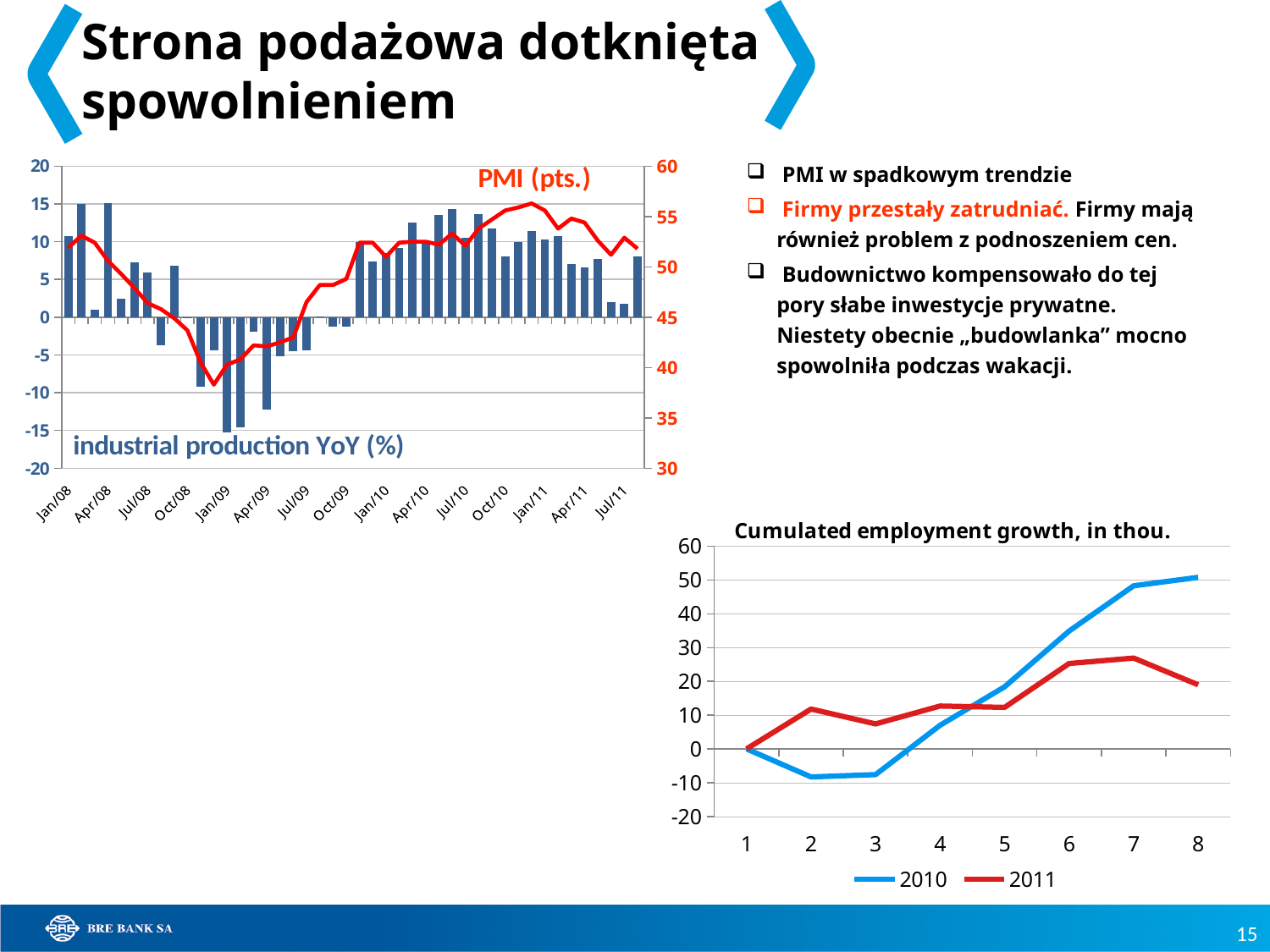
On the 'Cumulated employment growth, in thou.' chart, which series has the higher value at point 8, 2010 or 2011? 2010 On the 'Cumulated employment growth, in thou.' chart, how many points are on the x axis? 8 On the left chart, what kind of chart is used to show industrial production YoY (%)? bar chart On the 'Cumulated employment growth, in thou.' chart, how many series does the legend list? 2 What kind of chart is the 'Cumulated employment growth, in thou.' chart? line chart On the 'Cumulated employment growth, in thou.' chart, does the 2010 series rise or fall from point 2 to point 8? rise On the 'Cumulated employment growth, in thou.' chart, is the value for 2011 at point 8 greater or less than 30? less On the 'Cumulated employment growth, in thou.' chart, is the value for 2010 at point 8 greater or less than 40? greater On the 'Cumulated employment growth, in thou.' chart, what is the value for 2010 at point 1? 0 On the 'Cumulated employment growth, in thou.' chart, which series has the higher value at point 2, 2010 or 2011? 2011 On the 'Cumulated employment growth, in thou.' chart, at which point does the 2011 series reach its highest value? 7